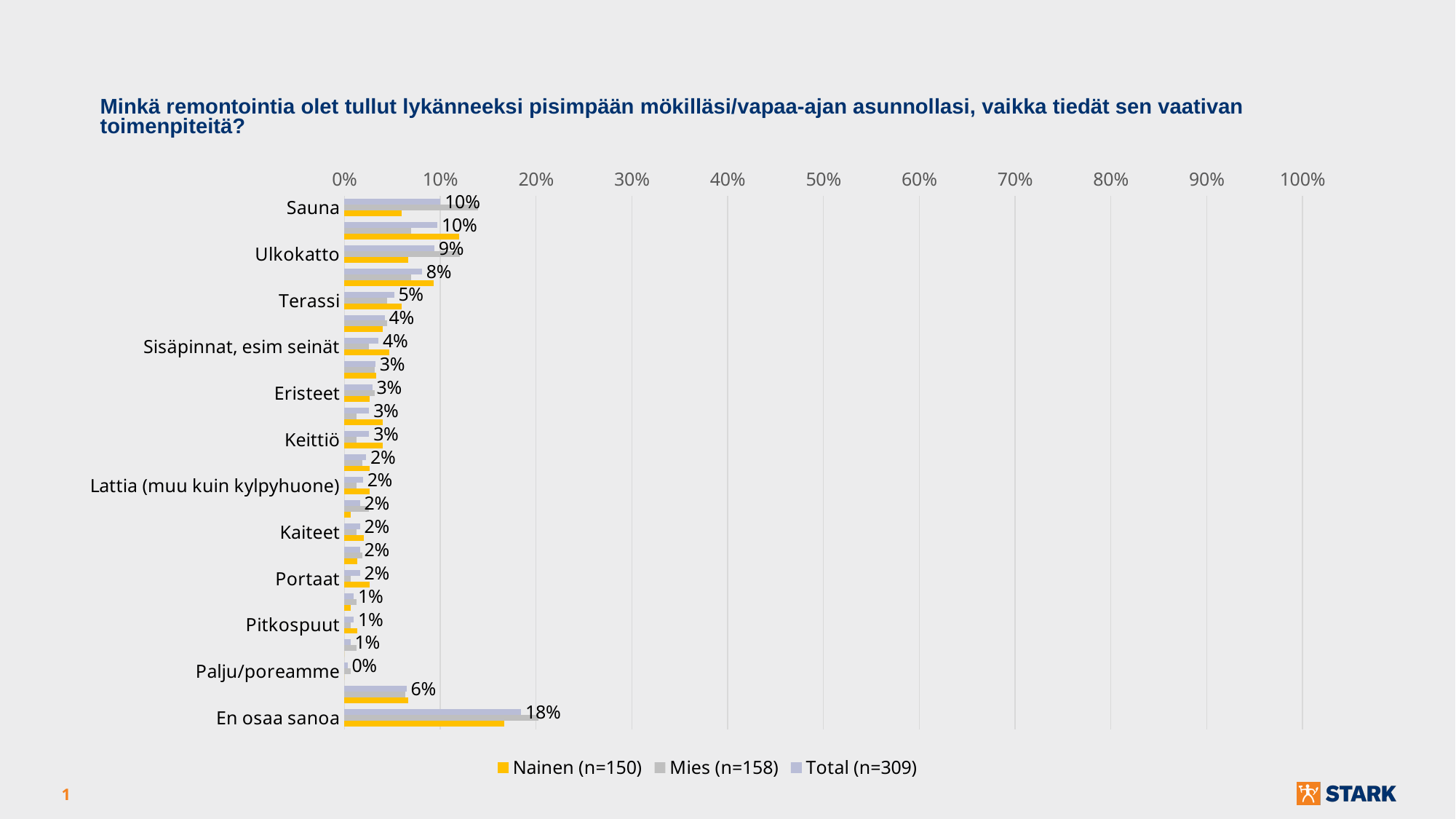
What is the Total (n=309) value for Sauna? 10% Which has the larger Total (n=309) value, Sauna or Terassi? Sauna Which labelled category has the lowest Total (n=309) value? Palju/poreamme What is the Total (n=309) value for Palju/poreamme? 0% What is the Total (n=309) value for En osaa sanoa? 18% What is the Total (n=309) value for Terassi? 5% What kind of chart is shown on the slide? Bar chart Which labelled category has the highest Total (n=309) value? En osaa sanoa How many series does the legend list? 3 Is the Nainen (n=150) value for En osaa sanoa greater or less than 10%? greater What is the difference between the Total (n=309) values for En osaa sanoa and Sauna? 8 percentage points What is the Total (n=309) value for Ulkokatto? 9%